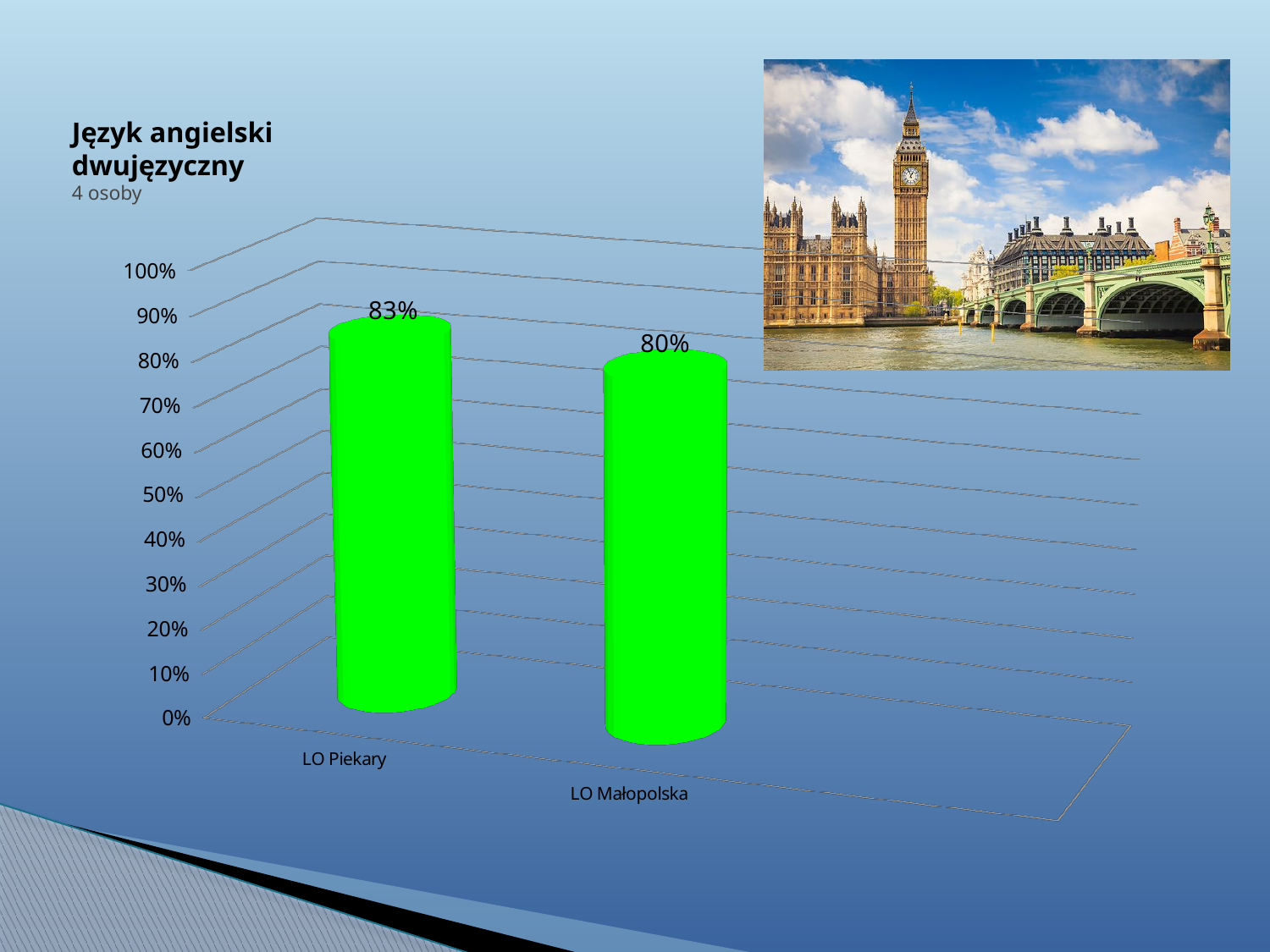
What is the value for LO Małopolska? 80% Which is larger, the value for LO Piekary or the value for LO Małopolska? LO Piekary What is the difference between the values for LO Piekary and LO Małopolska? 3% What is the title of the slide above the chart? Język angielski dwujęzyczny What colour are the bars in the chart? green Is the value for LO Małopolska greater or less than 90%? less Is the value for LO Piekary greater or less than 70%? greater Which category has the highest value? LO Piekary What kind of chart is shown on the slide? bar chart How many categories are shown in the chart? 2 What is the value for LO Piekary? 83% Which category has the lowest value? LO Małopolska